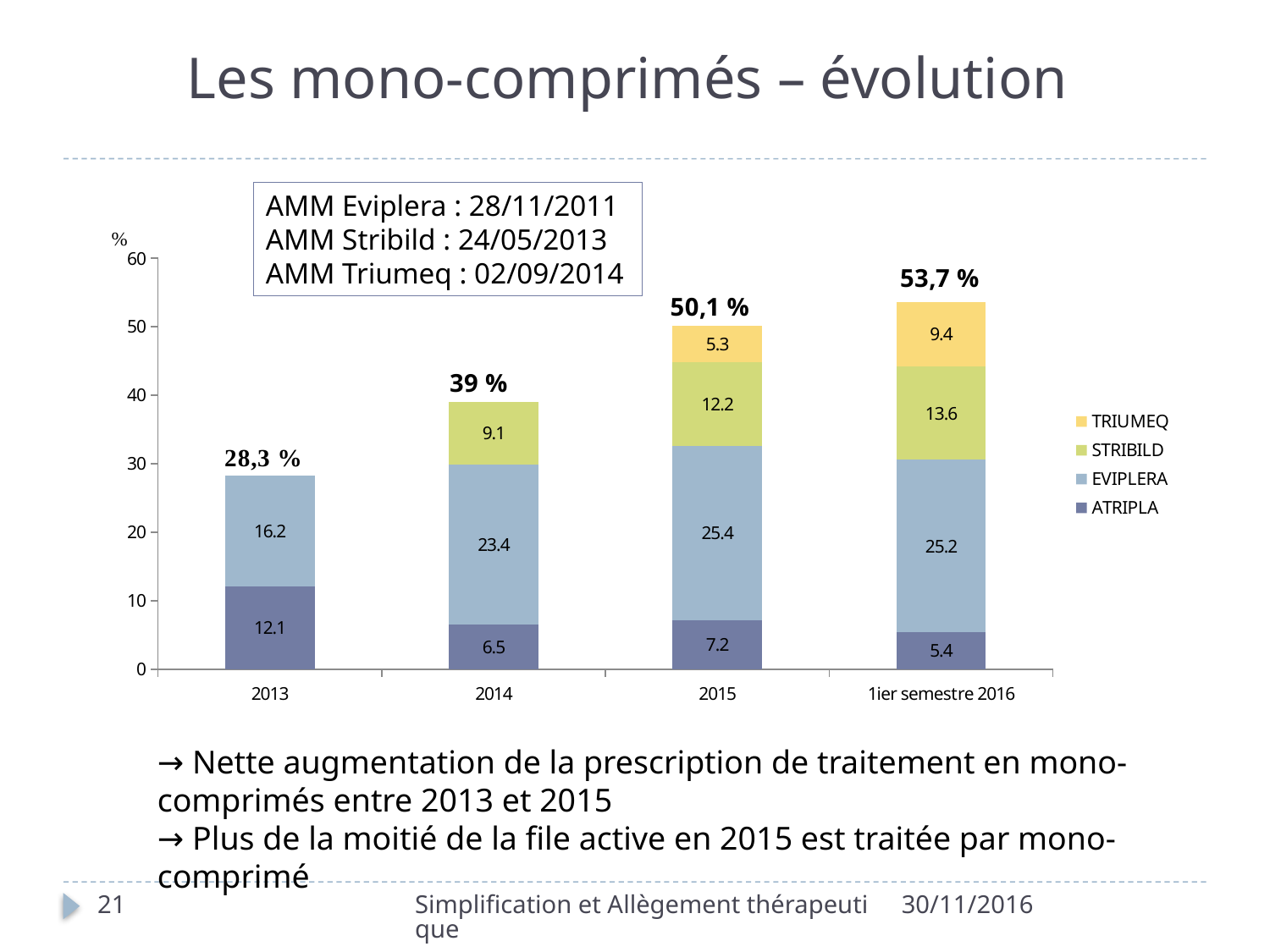
How many series does the legend list? 4 What kind of chart is shown on the slide? Stacked bar chart What is the value for ATRIPLA in 2013? 12.1 What is the total shown above the stacked bar for 2015? 50,1 % What is the value for TRIUMEQ in 1ier semestre 2016? 9.4 Which is larger, the EVIPLERA value in 2015 or in 1ier semestre 2016? 2015 What is the total shown above the stacked bar for 2013? 28,3 % How many categories are shown on the x axis? 4 Which year has the highest value for ATRIPLA? 2013 What is the value for EVIPLERA in 2014? 23.4 What is the difference between the STRIBILD values for 1ier semestre 2016 and 2015? 1.4 Which category has the lowest value for STRIBILD among those where it is plotted? 2014